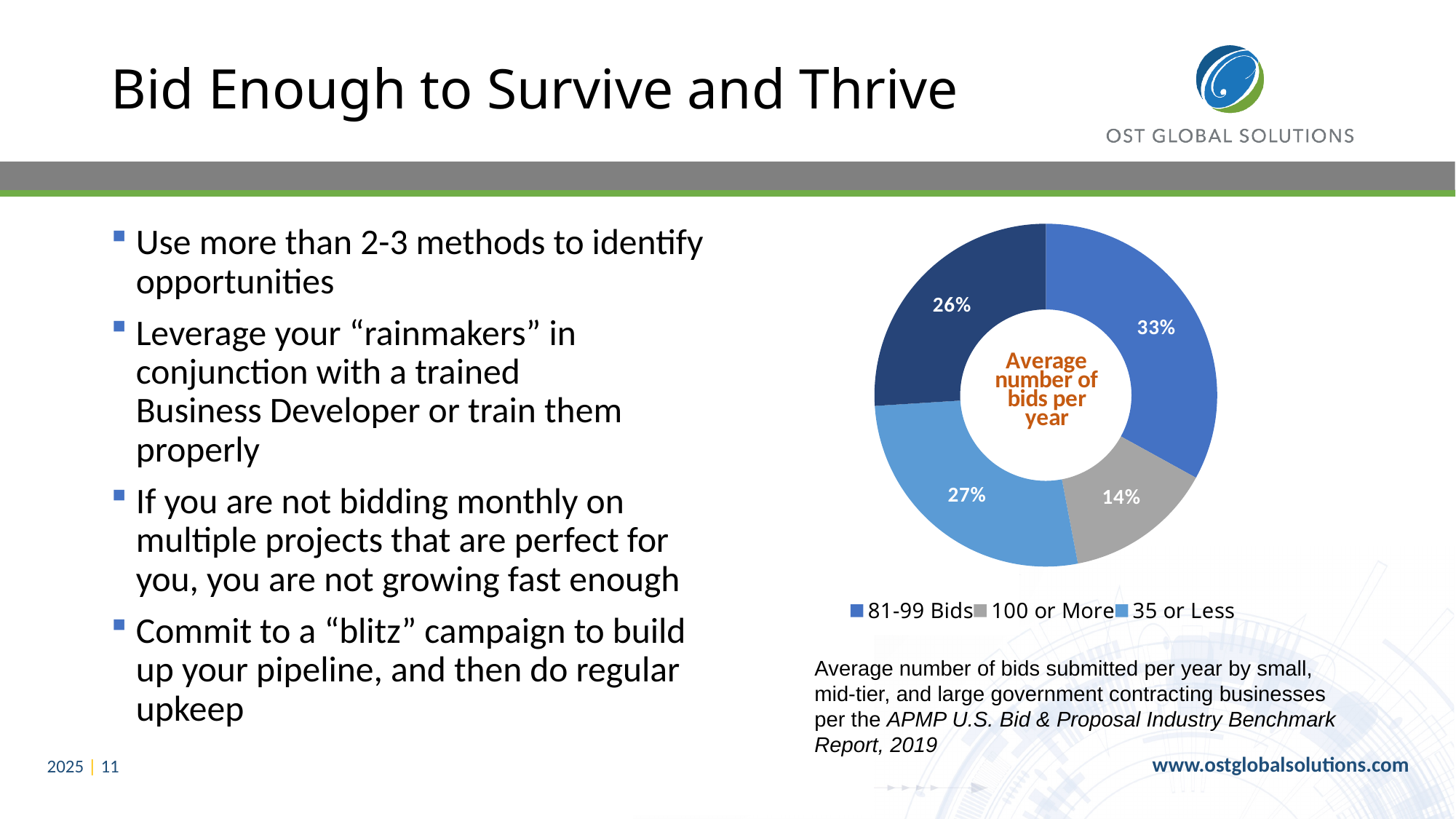
How many percentage points larger is the 81-99 Bids slice than the 100 or More slice? 19 percentage points What type of chart is shown on the slide? Doughnut (pie) chart Which slice is larger, 35 or Less or 100 or More? 35 or Less Which category has the smallest slice in the chart? 100 or More Which labelled category has the largest slice in the chart? 81-99 Bids What percentage does the 35 or Less slice represent? 27% What colour is the 100 or More slice? Gray What percentage does the 100 or More slice represent? 14% How many percentage points larger is the 35 or Less slice than the 100 or More slice? 13 percentage points What percentage of the doughnut chart is the 81-99 Bids slice? 33% What text appears in the centre of the doughnut chart? Average number of bids per year How many slices does the chart have? 4